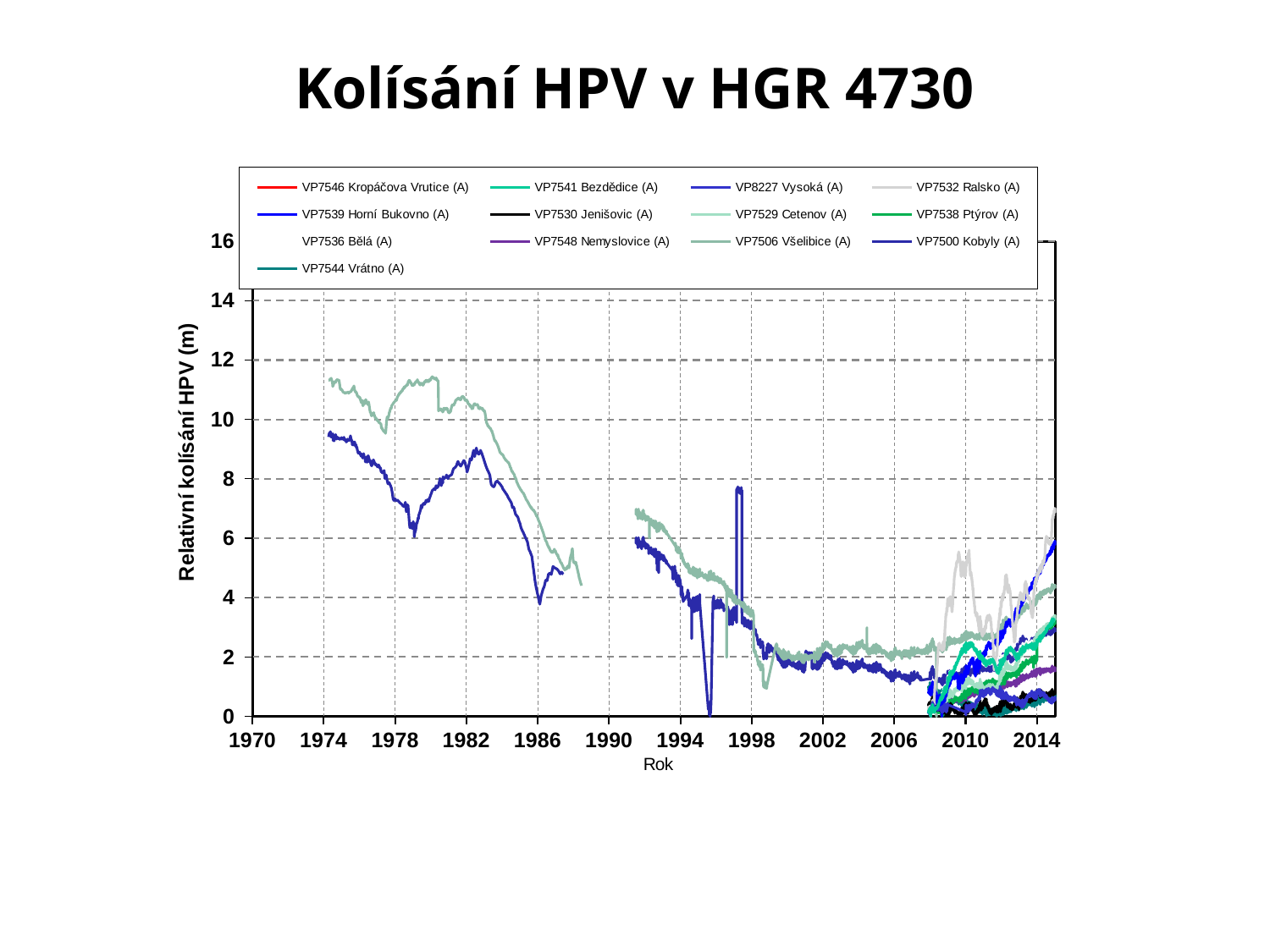
What is the label of the y axis? Relativní kolísání HPV (m) What is the title of the chart? Kolísání HPV v HGR 4730 Is the value of the lowest line in 1986 greater or less than 6? less Is the value of the topmost line in 1992 greater or less than 6? greater What is the highest value shown on the y axis? 16 How many series does the legend list? 13 What is the first year shown on the x axis? 1970 Is the value of the topmost line in 1975 greater or less than 10? greater Does the topmost line rise or fall between 1983 and 1986? fall What kind of chart is shown on the slide? line chart Do the values of the lines generally rise or fall between 1992 and 1999? fall